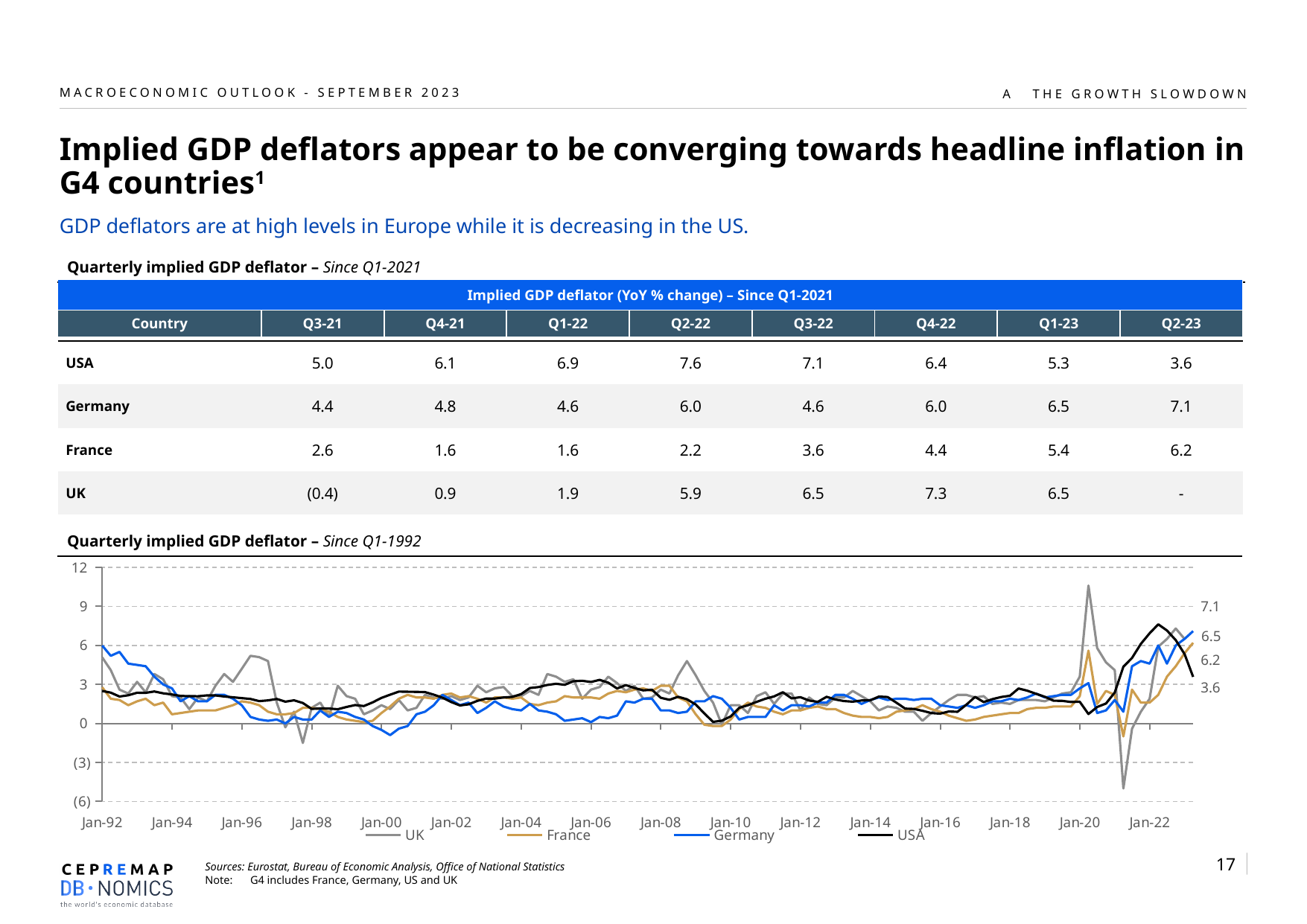
In the line chart, does the USA line rise or fall from Jan-22 to the end of the series? fall In the line chart, is the trough of the UK line around Jan-20 greater or less than (3)? less In the line chart, is the peak of the UK line around Jan-20 greater or less than 9? greater In the line chart, what is the difference between the end labels for Germany (7.1) and USA (3.6)? 3.5 What colour is the Germany line in the line chart? blue What is the latest value labelled for the USA line in the line chart? 3.6 Which series in the line chart has the highest value at the end of the series, according to the end labels? Germany In the line chart, is the end value for Germany or France larger? Germany What is the latest value labelled for the Germany line in the line chart? 7.1 What kind of chart is shown under 'Quarterly implied GDP deflator – Since Q1-1992'? line chart Which series in the line chart has the lowest value at the end of the series, according to the end labels? USA How many series does the legend of the line chart list? 4